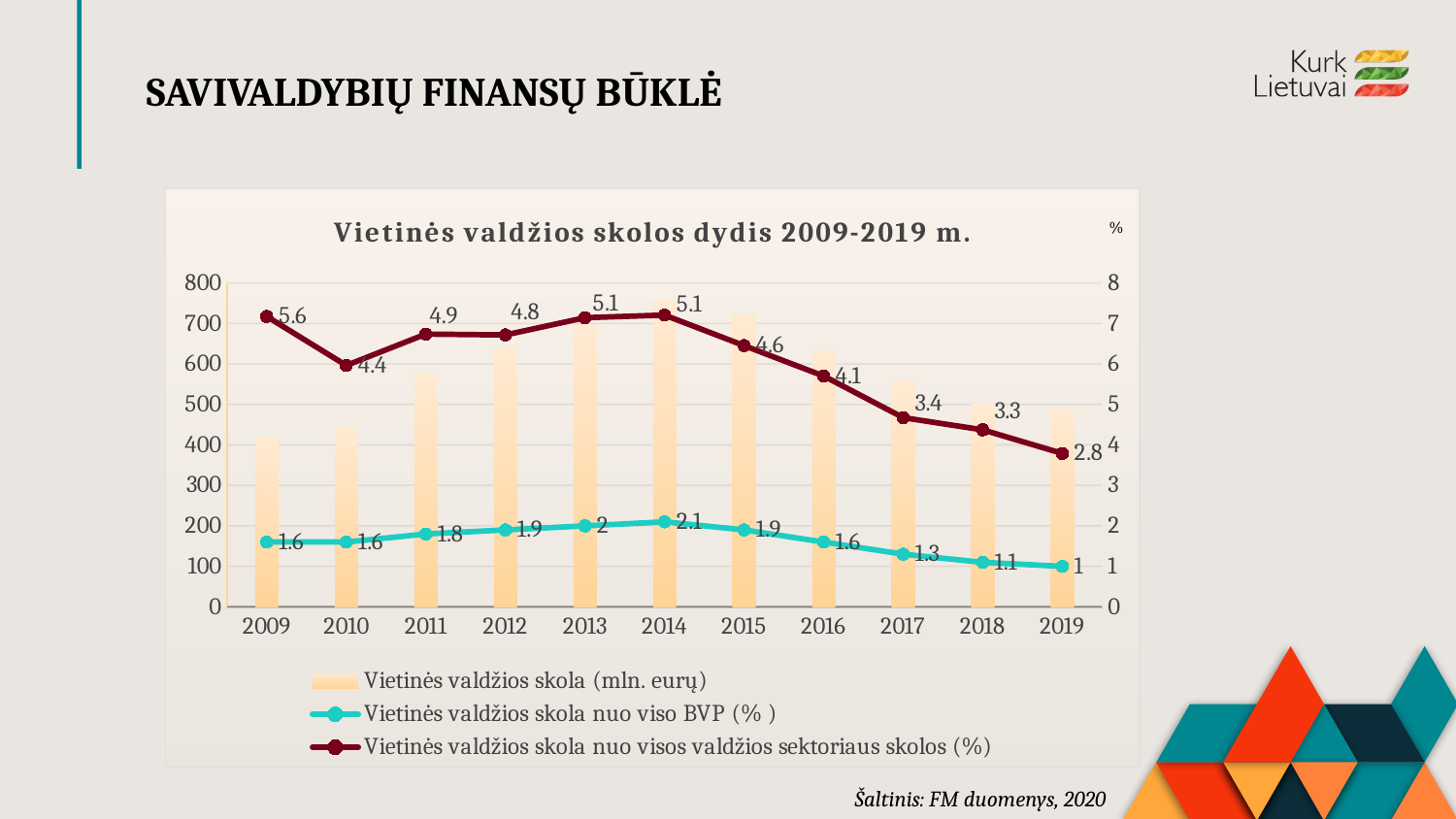
How many series does the legend list? 3 In which year is 'Vietinės valdžios skola nuo visos valdžios sektoriaus skolos (%)' lowest? 2019 What is the value of 'Vietinės valdžios skola nuo visos valdžios sektoriaus skolos (%)' in 2009? 5.6 Is the value of 'Vietinės valdžios skola (mln. eurų)' in 2013 greater or less than 600? greater What type of chart is shown on the slide? Combined bar and line chart What is the difference between the 2009 and 2019 values of 'Vietinės valdžios skola nuo visos valdžios sektoriaus skolos (%)'? 2.8 What is the title of the chart? Vietinės valdžios skolos dydis 2009-2019 m. In which year is 'Vietinės valdžios skola nuo viso BVP (%)' highest? 2014 How many years are shown on the x axis? 11 Which is larger: 'Vietinės valdžios skola nuo viso BVP (%)' in 2012 or in 2017? 2012 Does 'Vietinės valdžios skola nuo visos valdžios sektoriaus skolos (%)' rise or fall from 2014 to 2019? fall What is the value of 'Vietinės valdžios skola nuo viso BVP (%)' in 2014? 2.1